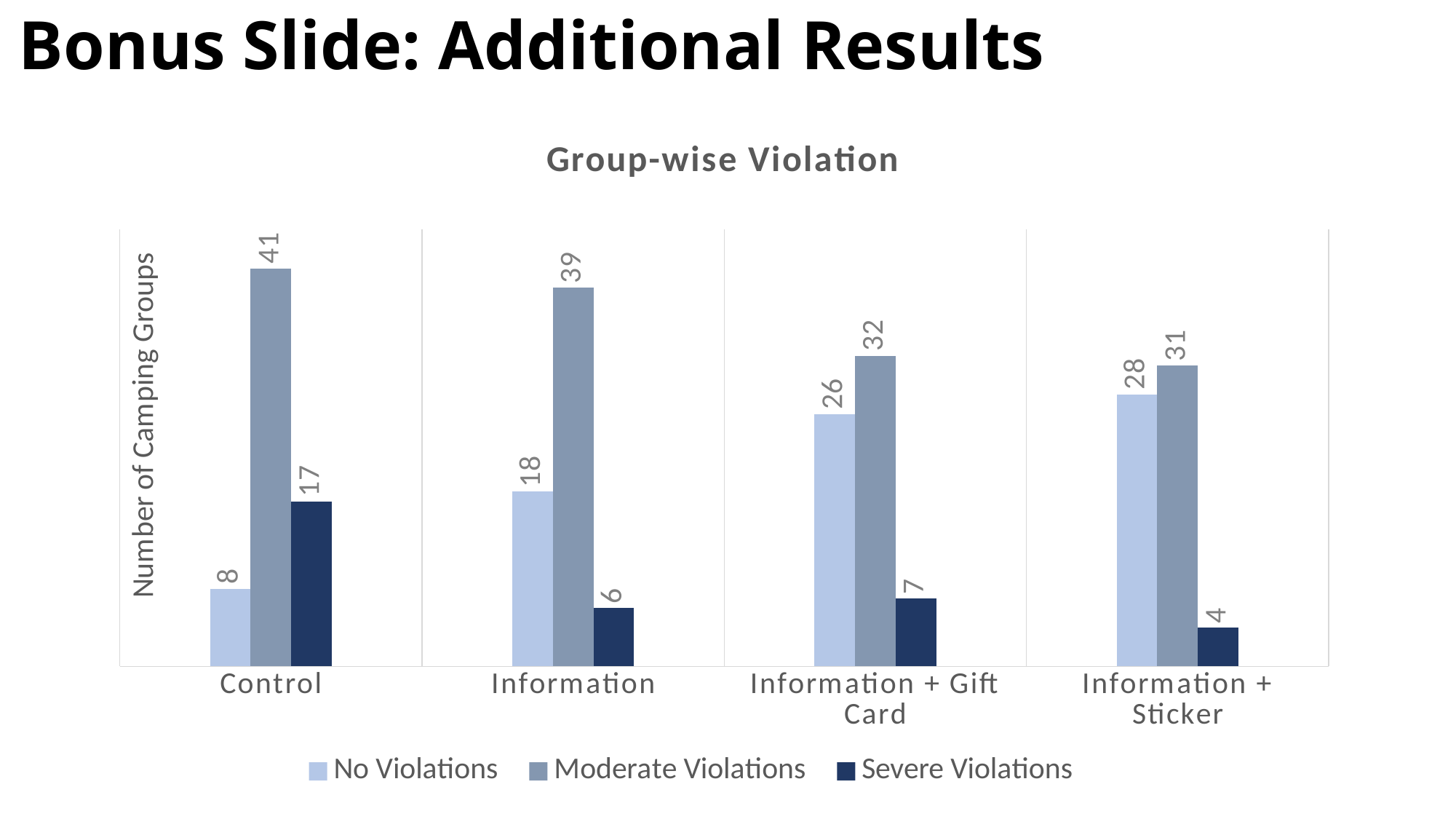
How many groups are shown on the x axis? 4 How many series does the legend list? 3 Which group has the highest number of No Violations? Information + Sticker What is the value for No Violations in the Information + Sticker group? 28 What is the value for Severe Violations in the Information + Gift Card group? 7 What is the difference between Moderate Violations and No Violations in the Control group? 33 Which is larger: Severe Violations in Control or Severe Violations in Information? Control What is the title of the chart? Group-wise Violation Which group has the lowest number of Severe Violations? Information + Sticker What kind of chart is shown? Bar chart What is the value for Moderate Violations in the Control group? 41